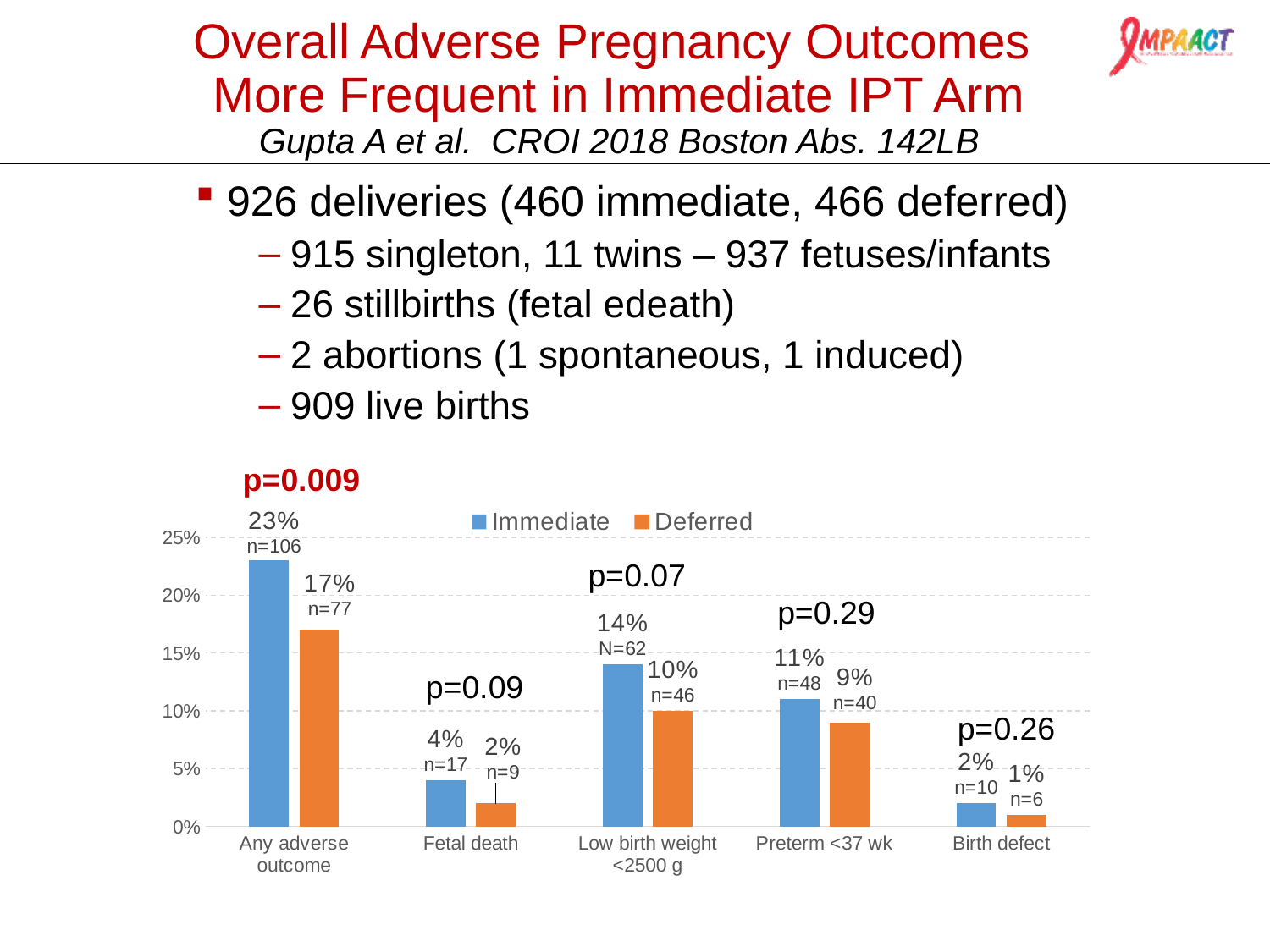
How many categories are shown on the x axis? 5 Which is larger for Fetal death, the Immediate or the Deferred value? Immediate What is the Immediate value for Preterm <37 wk? 11% What kind of chart is shown on the slide? Bar chart What p-value is shown above the Any adverse outcome bars? p=0.009 Which category has the lowest Deferred value? Birth defect What is the Immediate value for Any adverse outcome? 23% What colour are the Deferred bars? Orange How many series does the legend list? 2 Which category has the highest Immediate value? Any adverse outcome What is the difference between the Immediate and Deferred values for Any adverse outcome? 6% What is the Deferred value for Low birth weight <2500 g? 10%